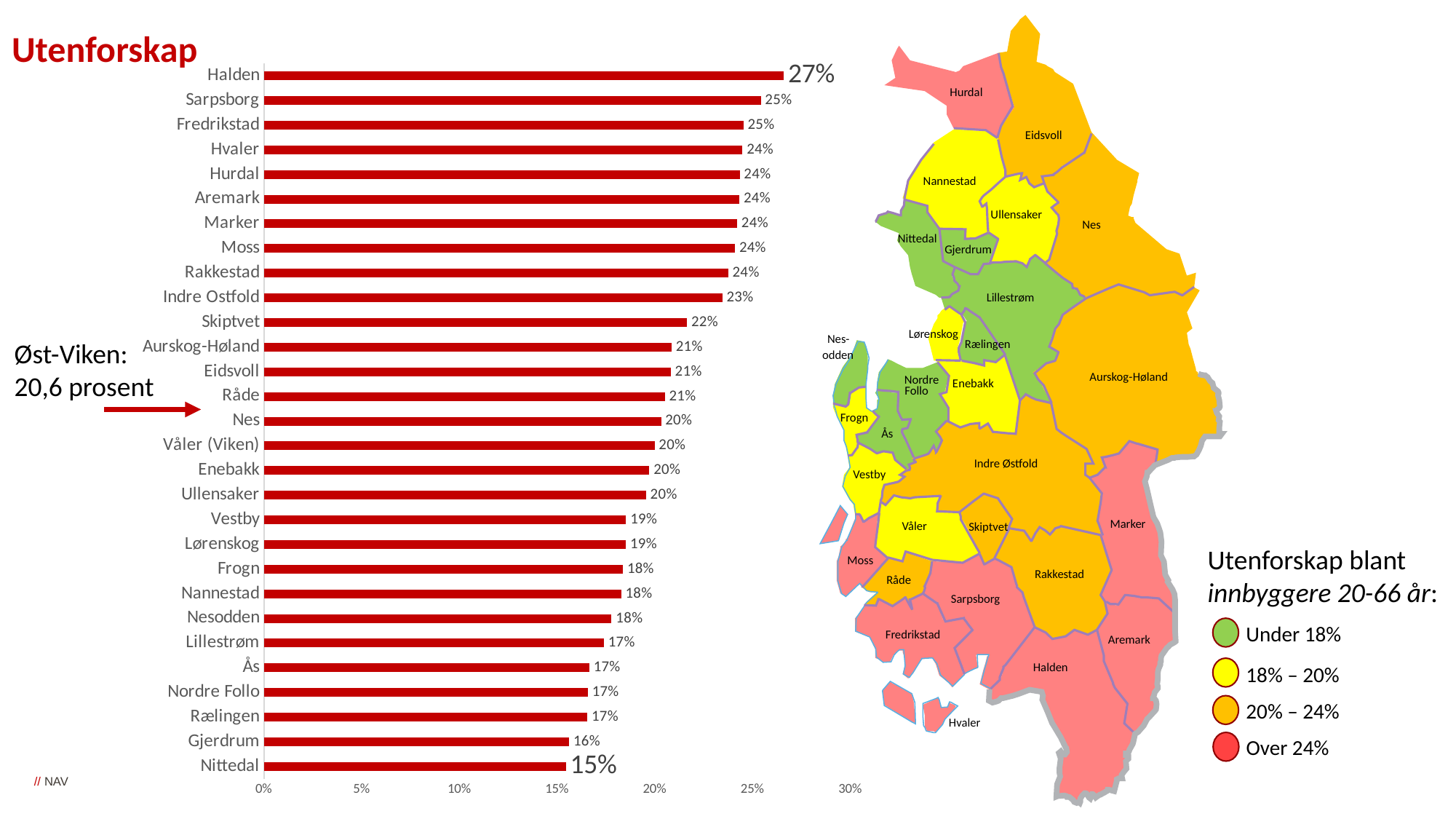
What kind of chart is used to show the municipality values? bar chart Which municipality has the lowest value? Nittedal What is the value for Skiptvet? 22% What is the difference between the values for Halden and Nittedal? 12% What is the value for Indre Østfold? 23% Is the value for Halden greater or less than 25%? greater How many municipalities are shown in the bar chart? 29 What is the value for Halden? 27% What is the value for Gjerdrum? 16% Which has a larger value, Sarpsborg or Skiptvet? Sarpsborg Which municipality has the highest value? Halden